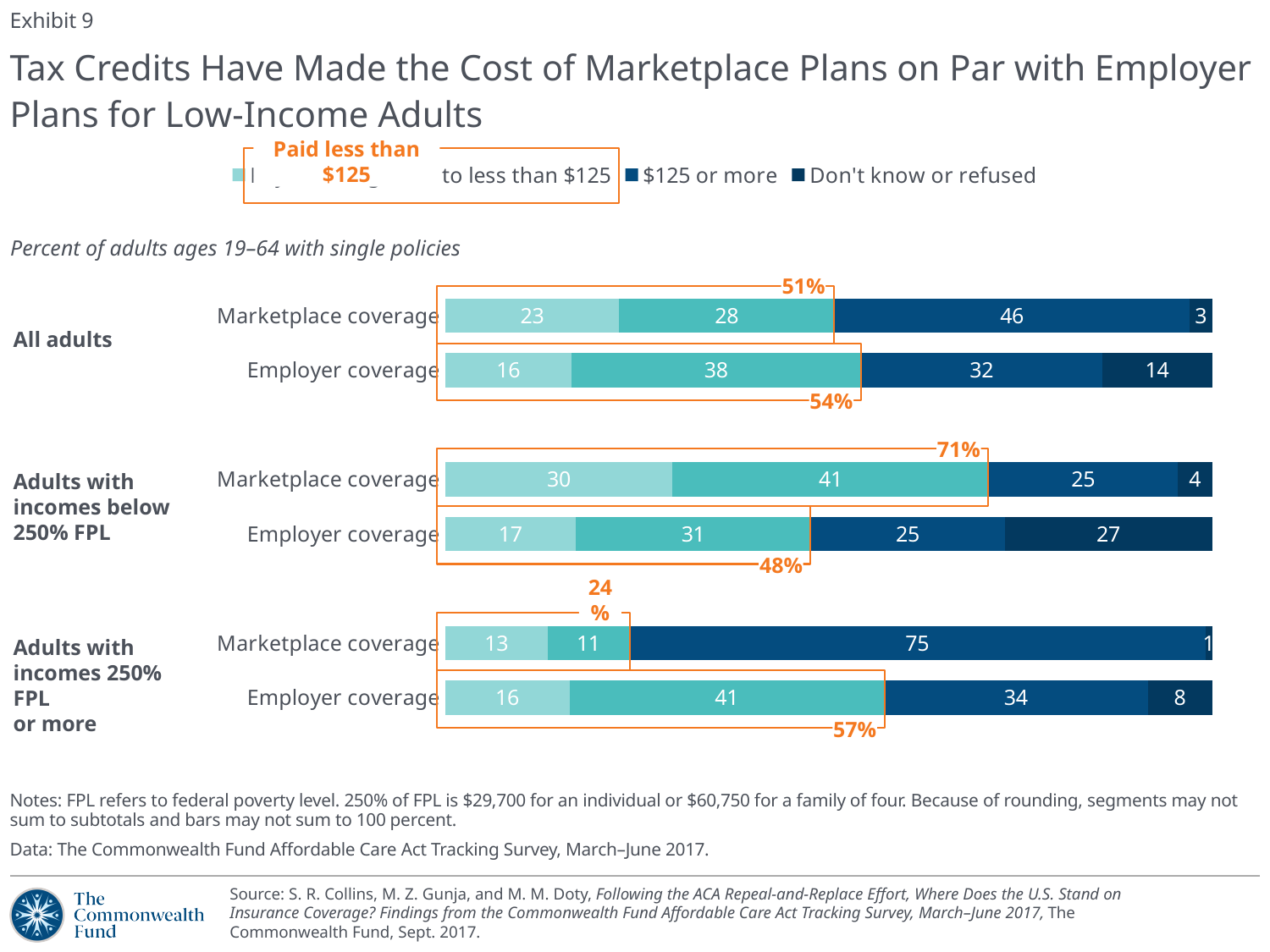
What is the "$125 or more" value for Marketplace coverage among all adults? 46 What is the "Don't know or refused" value for Employer coverage among adults with incomes below 250% FPL? 27 What is the orange subtotal label for Employer coverage among adults with incomes 250% FPL or more? 57% How many series does the legend list? 4 What percentage of adults with incomes below 250% FPL with Marketplace coverage paid less than $125, as shown by the orange subtotal label? 71% What is the difference between the "$125 or more" values for Marketplace coverage and Employer coverage among all adults? 14 What type of chart is shown on the slide? stacked bar chart Which bar has the highest "$125 or more" value? Marketplace coverage, adults with incomes 250% FPL or more Among adults with incomes below 250% FPL, which has the larger "Don't know or refused" value: Marketplace coverage or Employer coverage? Employer coverage What is the "$125 or more" value for Marketplace coverage among adults with incomes 250% FPL or more? 75 What is the "Don't know or refused" value for Employer coverage among all adults? 14 How many bars are plotted in the chart? 6